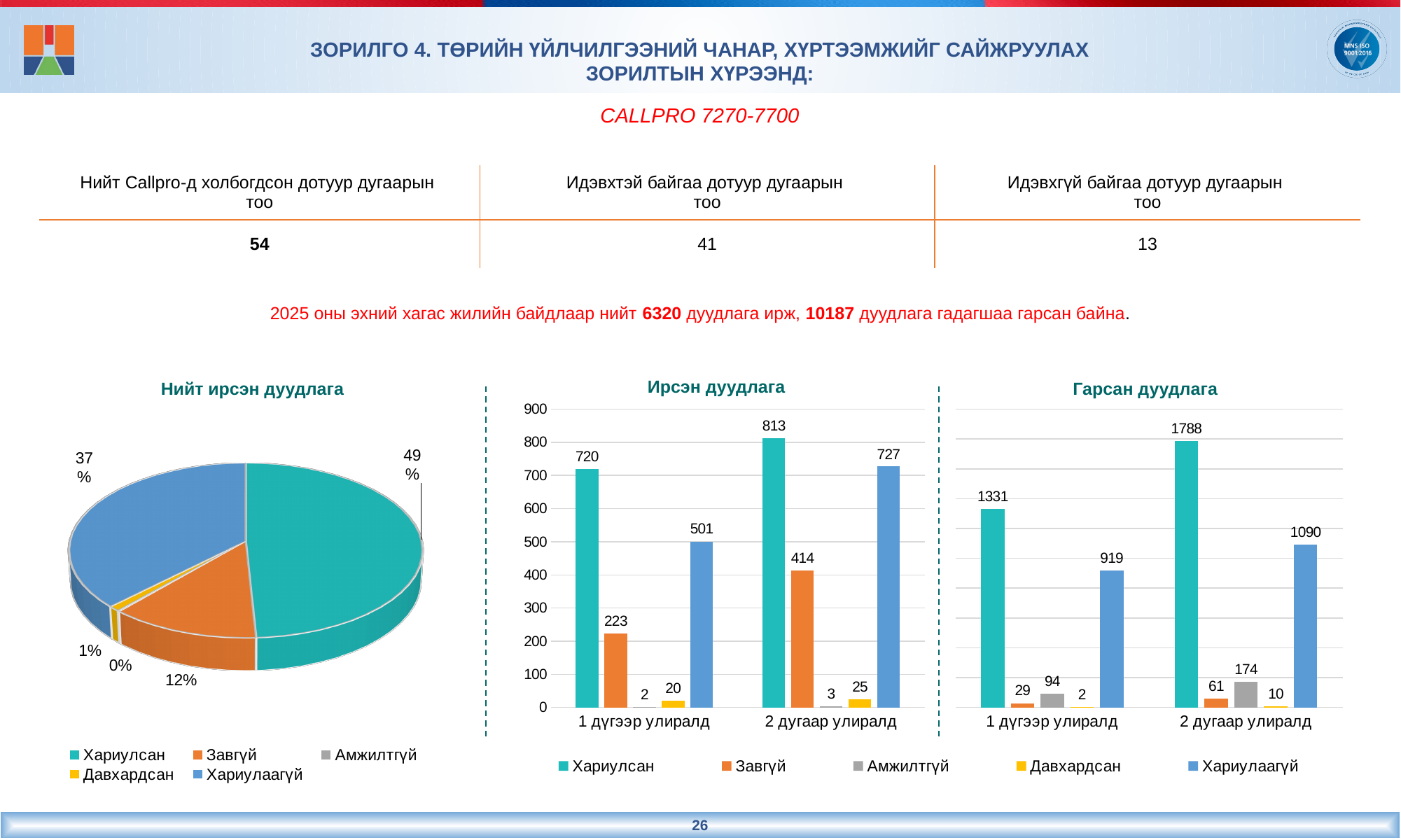
In the 'Ирсэн дуудлага' chart, which series has the highest value in 2 дугаар улиралд? Хариулсан In the 'Нийт ирсэн дуудлага' pie chart, what share does Хариулсан have? 49% In the 'Ирсэн дуудлага' chart, what is the value for Хариулаагүй in 2 дугаар улиралд? 727 In the 'Гарсан дуудлага' chart, what is the value for Хариулсан in 2 дугаар улиралд? 1788 In the 'Ирсэн дуудлага' chart, what is the value for Хариулсан in 1 дүгээр улиралд? 720 In the 'Гарсан дуудлага' chart, which series has the lowest value in 1 дүгээр улиралд? Давхардсан In the 'Нийт ирсэн дуудлага' pie chart, what share does Хариулаагүй have? 37% In the 'Ирсэн дуудлага' chart, what is the difference between the Завгүй values for 2 дугаар улиралд and 1 дүгээр улиралд? 191 In the 'Ирсэн дуудлага' chart, is the Хариулаагүй value for 1 дүгээр улиралд larger or the Завгүй value for 2 дугаар улиралд? Хариулаагүй for 1 дүгээр улиралд How many series does the legend of the 'Гарсан дуудлага' chart list? 5 In the 'Гарсан дуудлага' chart, what is the difference between the Хариулаагүй values for 2 дугаар улиралд and 1 дүгээр улиралд? 171 In the 'Гарсан дуудлага' chart, what is the value for Амжилтгүй in 1 дүгээр улиралд? 94